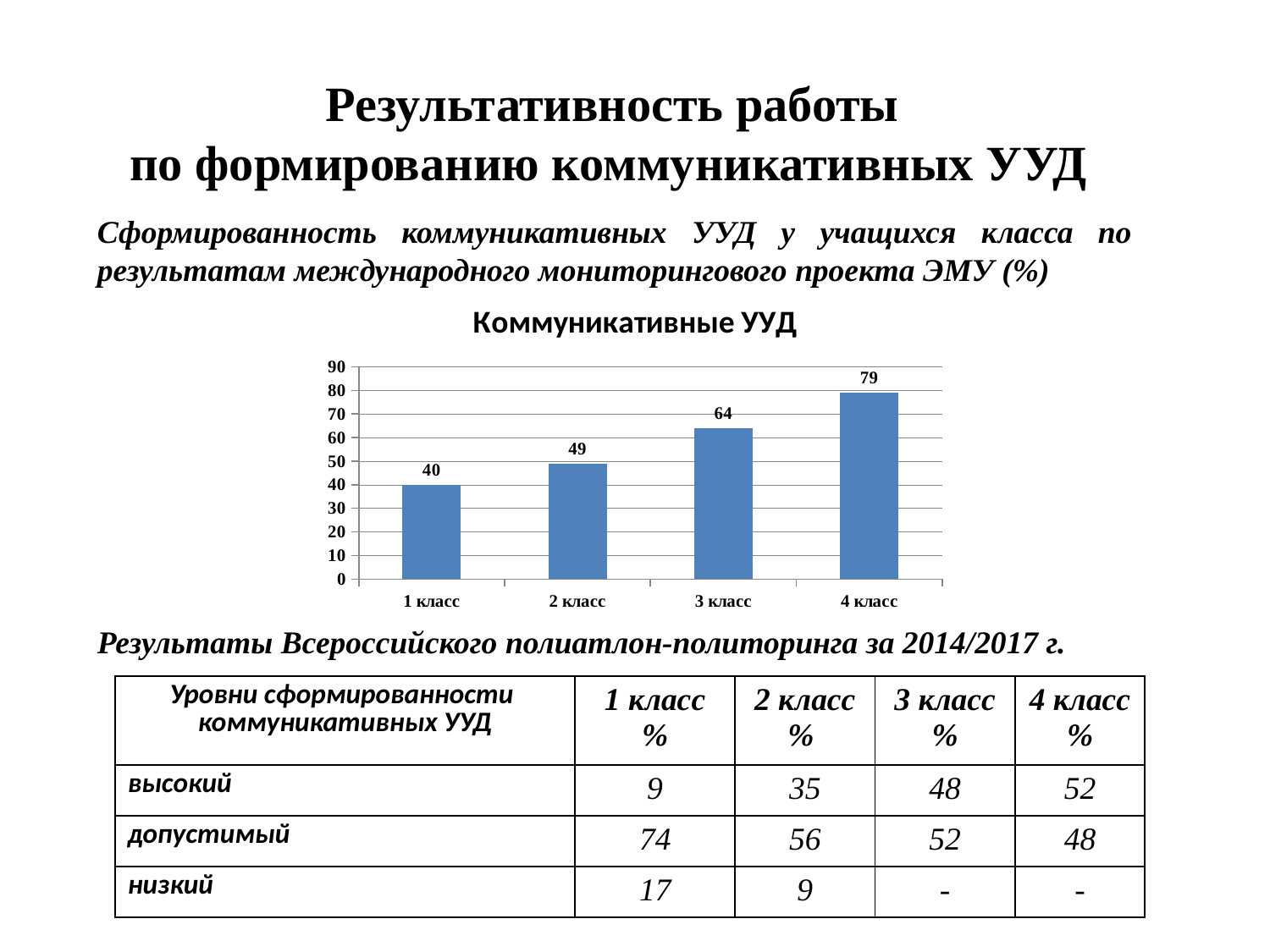
Which is larger, the value for 2 класс or the value for 3 класс? 3 класс Is the value for 2 класс greater or less than 60? less What is the value for 3 класс in the chart? 64 What is the value for 4 класс in the chart? 79 Which category has the highest value in the chart? 4 класс What is the difference between the values for 4 класс and 1 класс? 39 How many categories are shown on the x axis of the chart? 4 Which category has the lowest value in the chart? 1 класс Do the values rise or fall from 1 класс to 4 класс? rise What is the difference between the values for 3 класс and 2 класс? 15 What kind of chart is shown on the slide? bar chart What is the value for 1 класс in the chart? 40